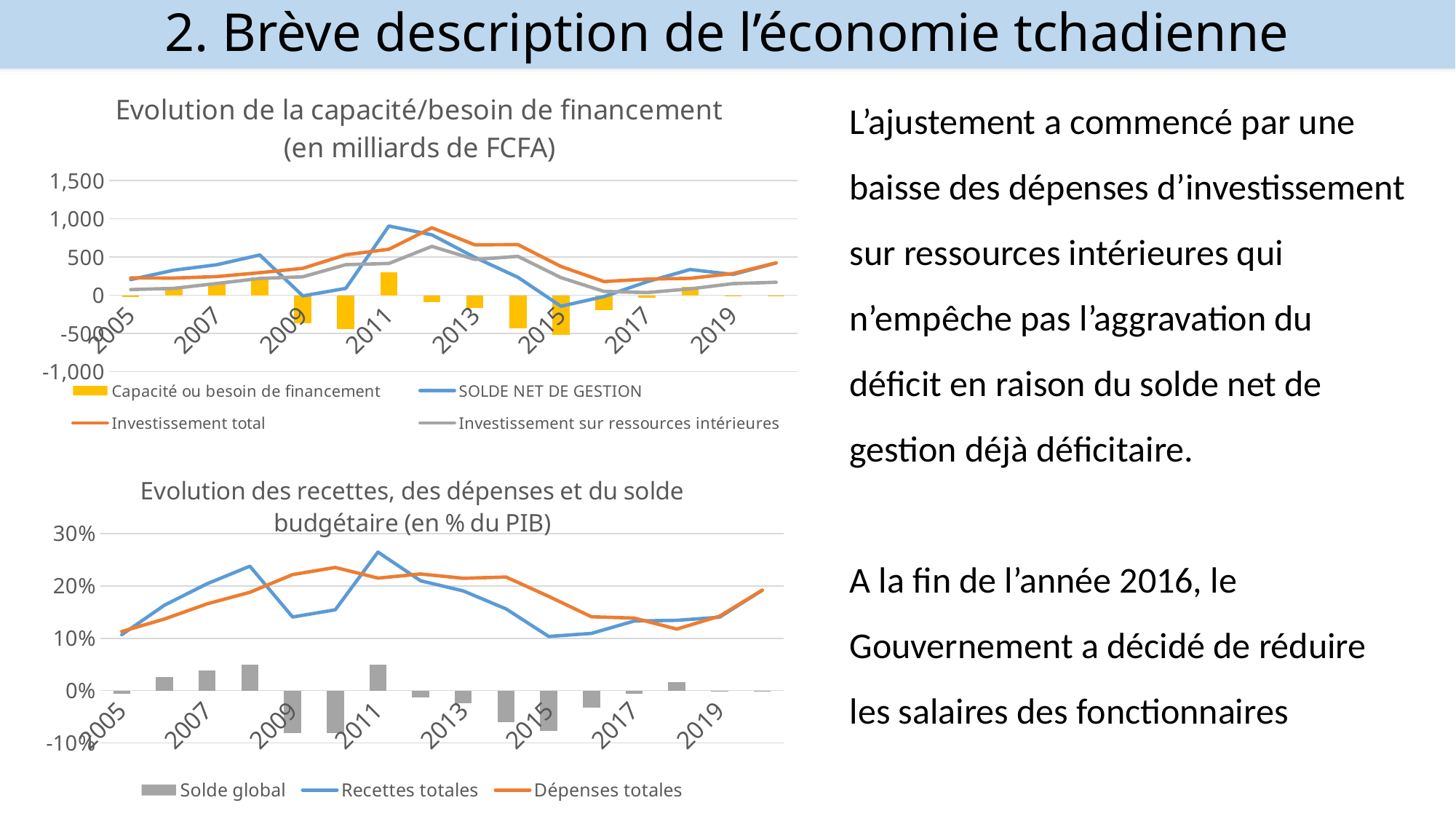
In the top chart, is the value of Capacité ou besoin de financement in 2015 greater or less than 0? less How many series does the legend of the top chart (capacité/besoin de financement) list? 4 In the top chart, what colour are the bars for Capacité ou besoin de financement? Yellow In the bottom chart, is the value of Solde global in 2009 greater or less than 0%? less What kind of chart is the top chart titled 'Evolution de la capacité/besoin de financement'? Combined bar and line chart In the top chart, which is larger in 2015: Investissement total or SOLDE NET DE GESTION? Investissement total In the top chart, which is larger in 2011: SOLDE NET DE GESTION or Investissement total? SOLDE NET DE GESTION In the top chart, is the value of SOLDE NET DE GESTION in 2011 greater or less than 500? greater In the bottom chart, which is larger in 2009: Recettes totales or Dépenses totales? Dépenses totales In the bottom chart, do Recettes totales rise or fall between 2011 and 2015? fall How many series does the legend of the bottom chart (recettes, dépenses et solde budgétaire) list? 3